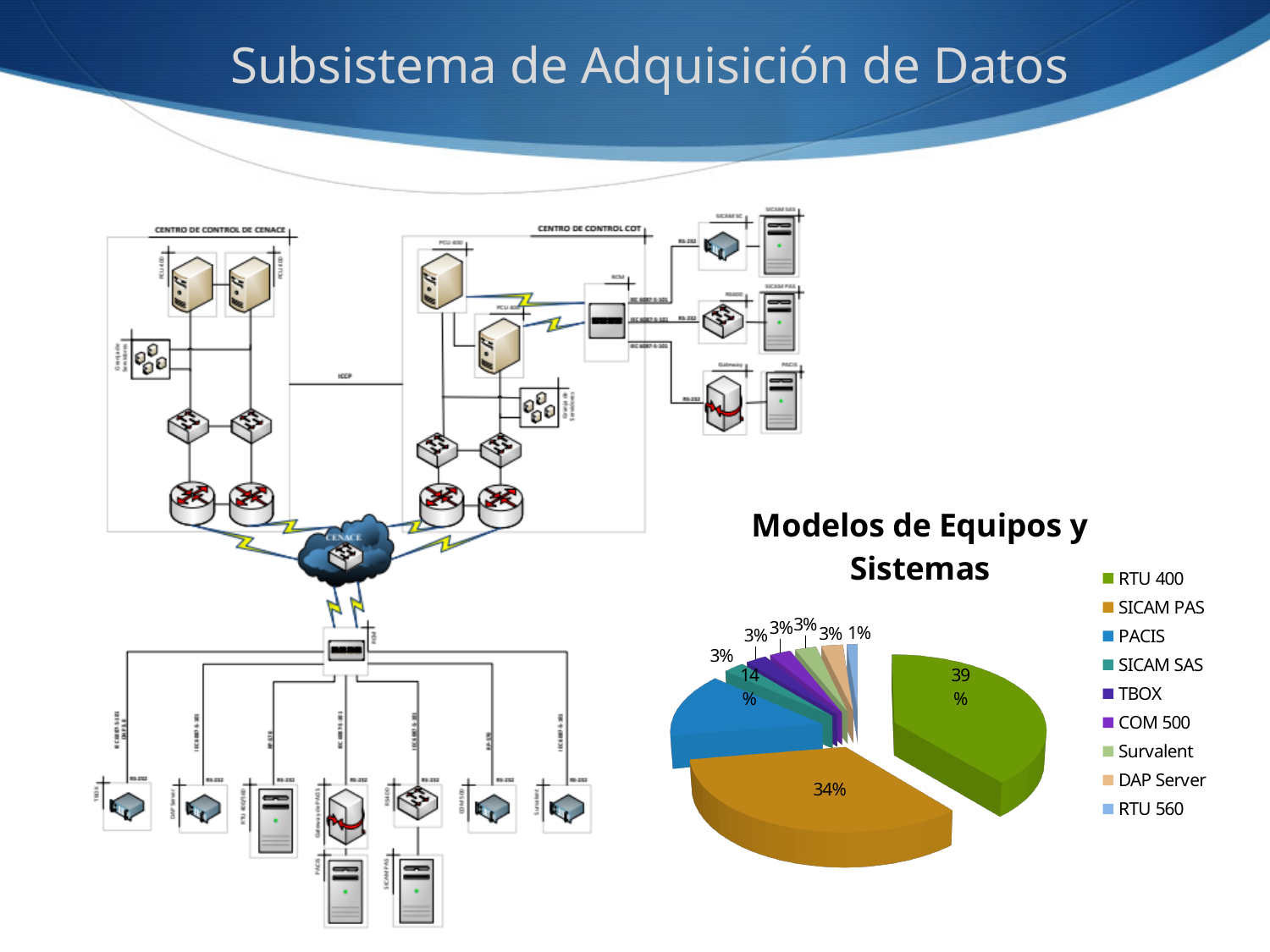
Which category has the largest slice of the pie? RTU 400 What is the difference in percentage points between the RTU 400 slice and the SICAM PAS slice? 5 percentage points What share of the pie does SICAM PAS have? 34% What is the title of the pie chart? Modelos de Equipos y Sistemas What share of the pie does PACIS have? 14% Which category has the smallest slice of the pie? RTU 560 What share of the pie does RTU 560 have? 1% What type of chart is shown on the slide? pie chart Which colour represents SICAM PAS in the pie chart? orange Which slice is larger, SICAM PAS or PACIS? SICAM PAS How many categories does the pie chart legend list? 9 What share of the pie does RTU 400 have? 39%